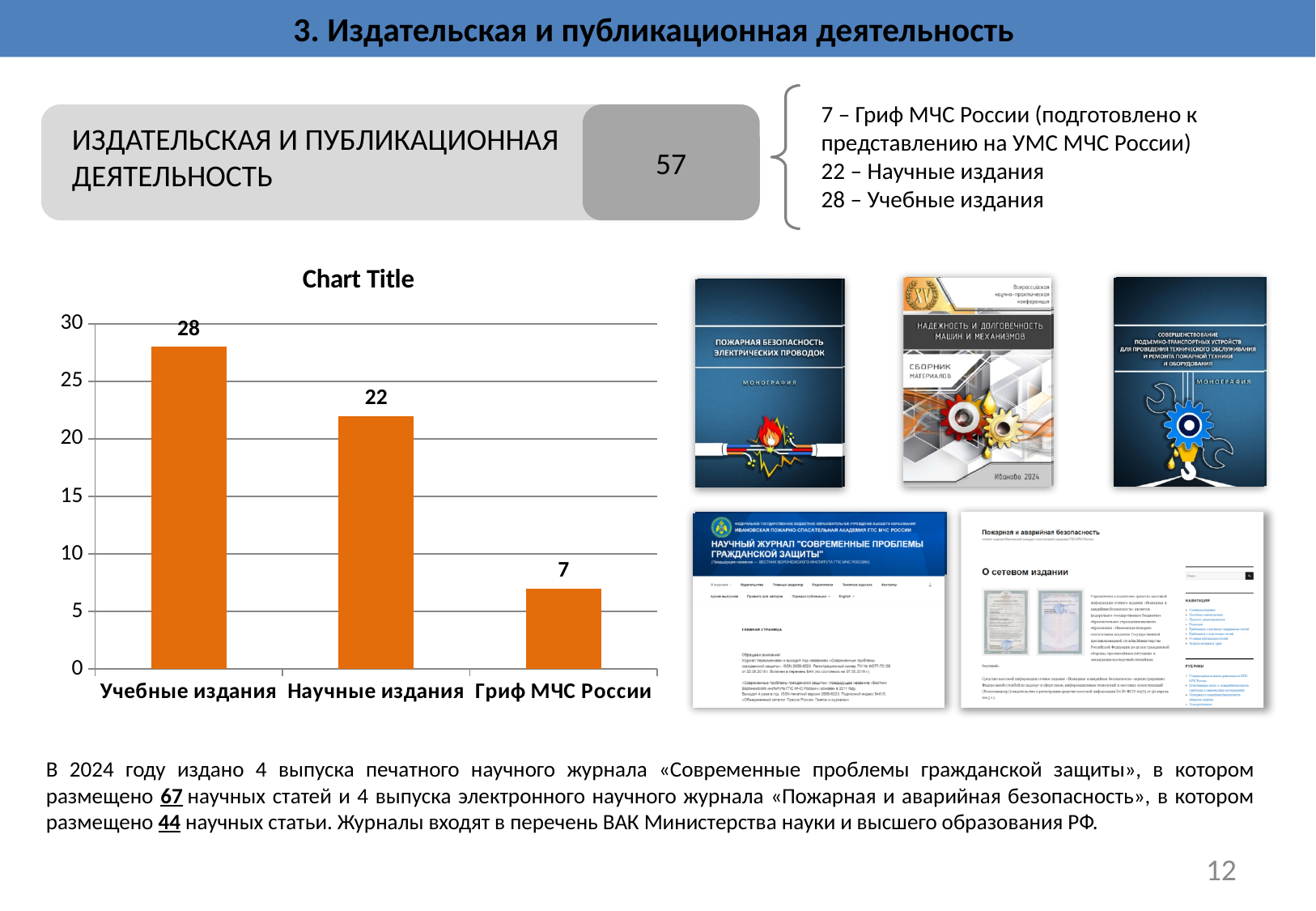
What is the value for Научные издания? 22 Which is larger, the value for Научные издания or the value for Гриф МЧС России? Научные издания What is the value for Гриф МЧС России? 7 How many categories are shown in the chart? 3 What is the title of the chart? Chart Title Which category has the highest value? Учебные издания Is the value for Гриф МЧС России greater or less than 10? less What is the difference between the values for Научные издания and Гриф МЧС России? 15 What is the difference between the values for Учебные издания and Научные издания? 6 What kind of chart is shown on the slide? bar chart Which category has the lowest value? Гриф МЧС России What is the value for Учебные издания? 28